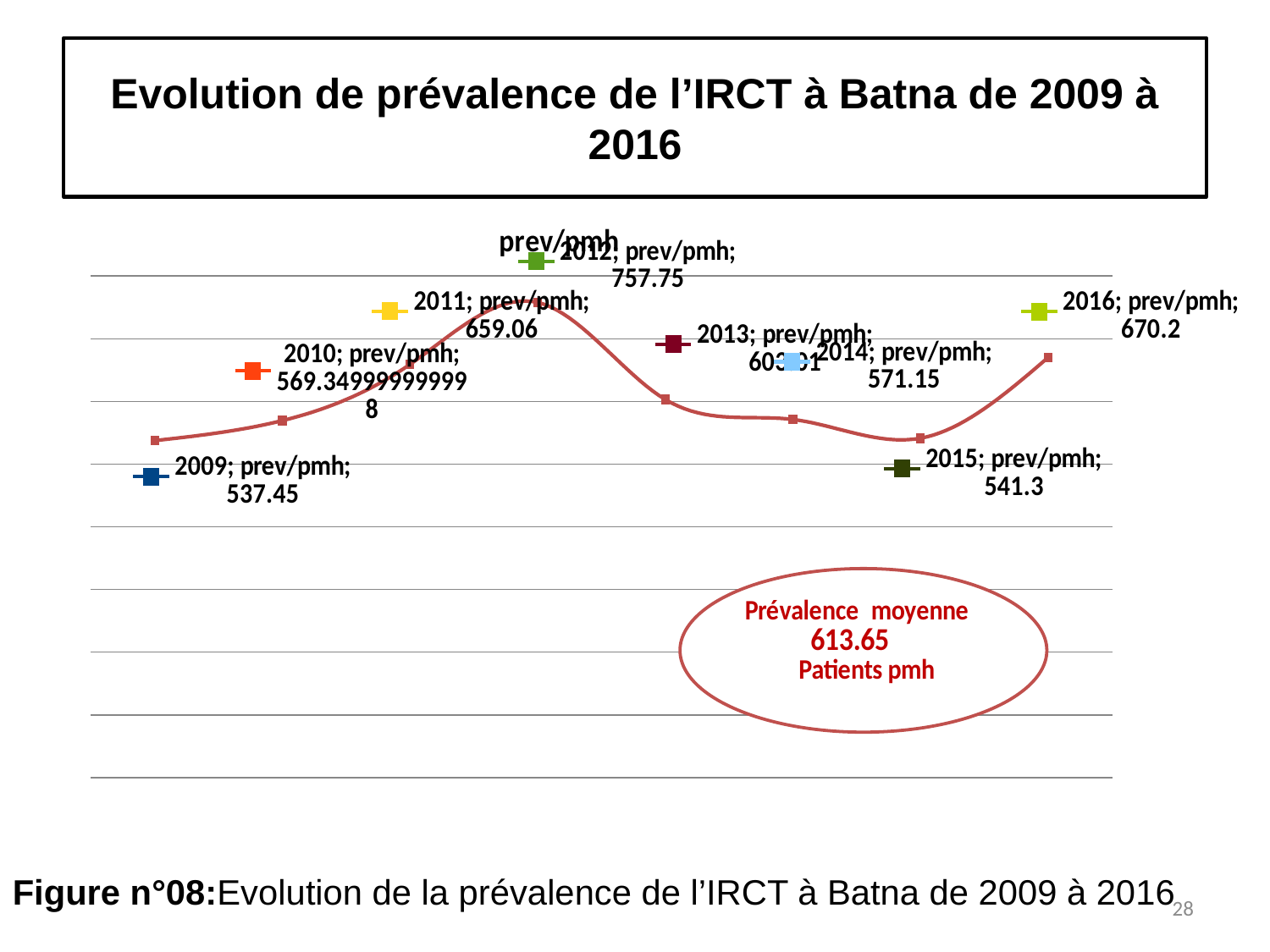
What is the prev/pmh value for 2012? 757.75 Which year has the lowest prev/pmh value? 2009 What is the difference between the prev/pmh values for 2012 and 2009? 220.3 What is the prev/pmh value for 2009? 537.45 What is the prev/pmh value for 2016? 670.2 Which year has the larger prev/pmh value, 2011 or 2016? 2016 What is the prev/pmh value for 2011? 659.06 What type of chart is shown on the slide? Line chart How many years are plotted on the chart? 8 What is the prev/pmh value for 2014? 571.15 Which year has the highest prev/pmh value? 2012 What is the prev/pmh value for 2015? 541.3